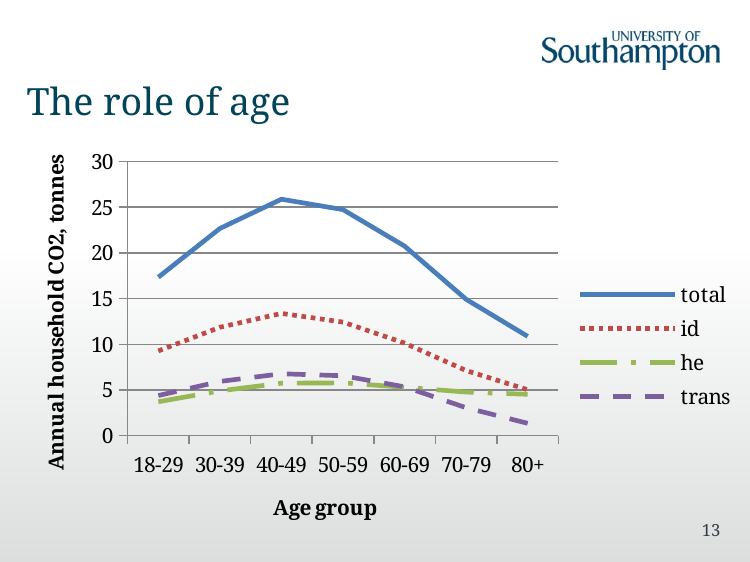
Is the value for total at 40-49 greater or less than 25? greater How many age groups are shown on the x axis? 7 Is the value for total at 80+ greater or less than 15? less How many series does the legend list? 4 Does the total series rise or fall from 40-49 to 80+? fall At 80+, which series has the larger value, he or trans? he What is the label of the y axis? Annual household CO2, tonnes Is the value for id at 40-49 greater or less than 10? greater Which age group has the lowest value for the total series? 80+ Which age group has the highest value for the total series? 40-49 What kind of chart is shown on the slide? line chart